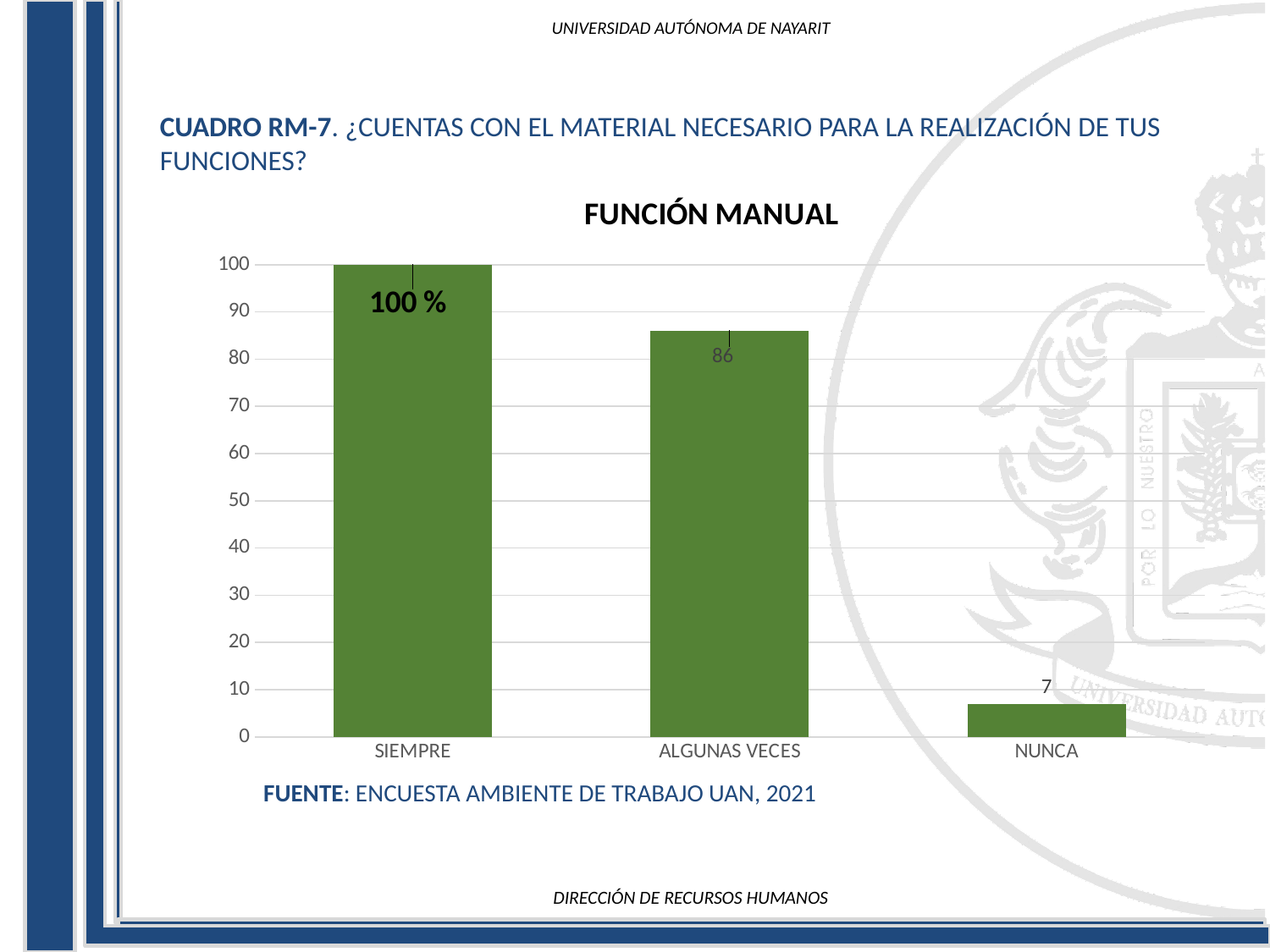
What is the value for NUNCA? 7 What is the difference between the values for ALGUNAS VECES and NUNCA? 79 What is the value for ALGUNAS VECES? 86 What kind of chart is shown? bar chart Which category has the lowest value? NUNCA Which is larger, the value for ALGUNAS VECES or the value for NUNCA? ALGUNAS VECES Is the value for ALGUNAS VECES greater or less than 80? greater How many categories are shown on the x axis? 3 Which category has the highest value? SIEMPRE Is the value for NUNCA greater or less than 10? less What is the title of the chart? FUNCIÓN MANUAL What is the value shown for SIEMPRE? 100 %